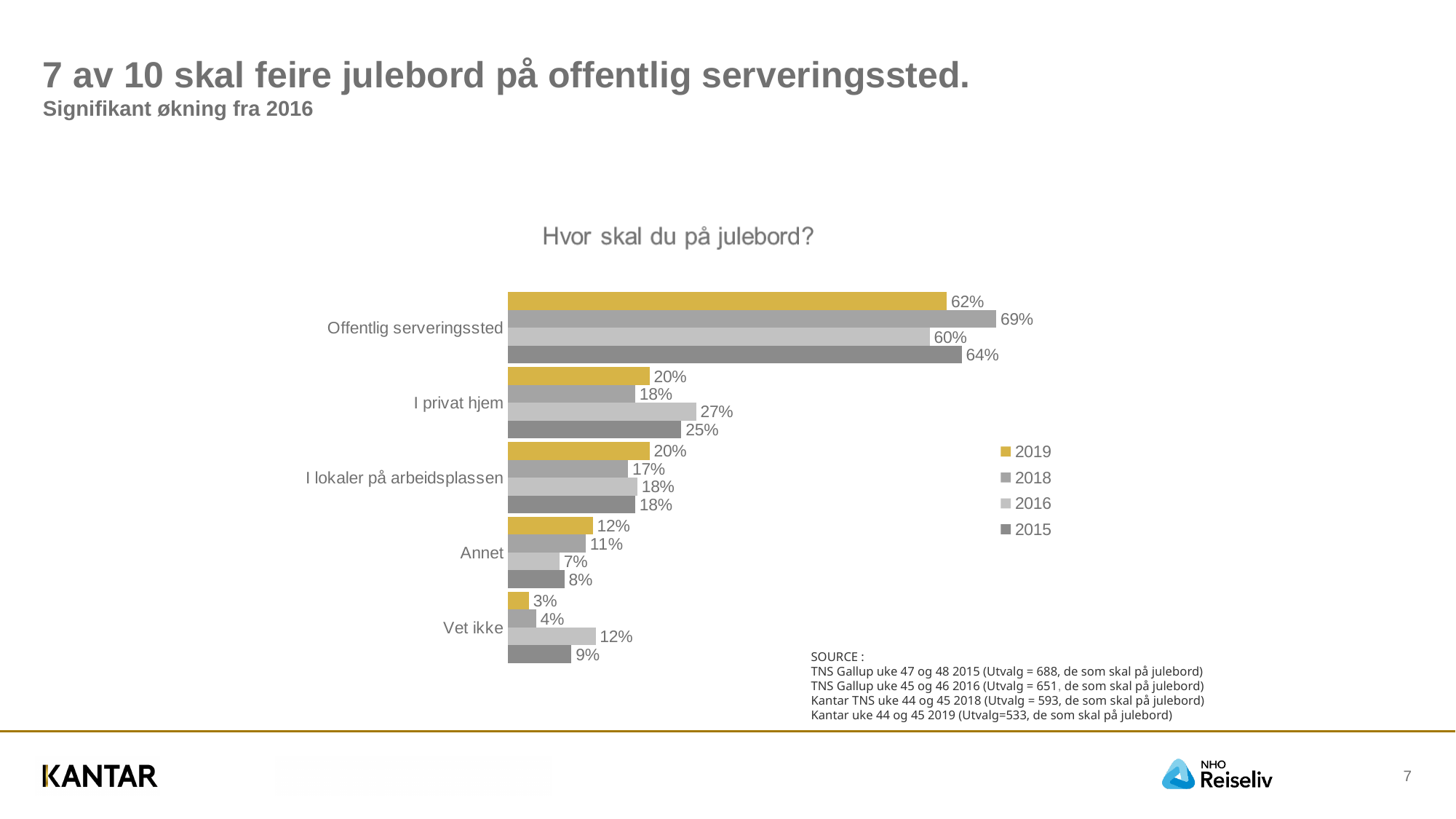
What is the value for Vet ikke in 2018? 4% Which category has the lowest value in the 2019 series? Vet ikke What is the value for Offentlig serveringssted in 2019? 62% What is the difference between the 2018 and 2019 values for Offentlig serveringssted? 7% What kind of chart is shown on the slide? Bar chart Which is larger for I privat hjem: the 2016 value or the 2018 value? 2016 How many series does the legend list? 4 Which category has the highest value in the 2018 series? Offentlig serveringssted How many categories are shown on the chart? 5 What is the value for I privat hjem in 2016? 27% What is the value for Annet in 2015? 8% What is the title of the chart? Hvor skal du på julebord?